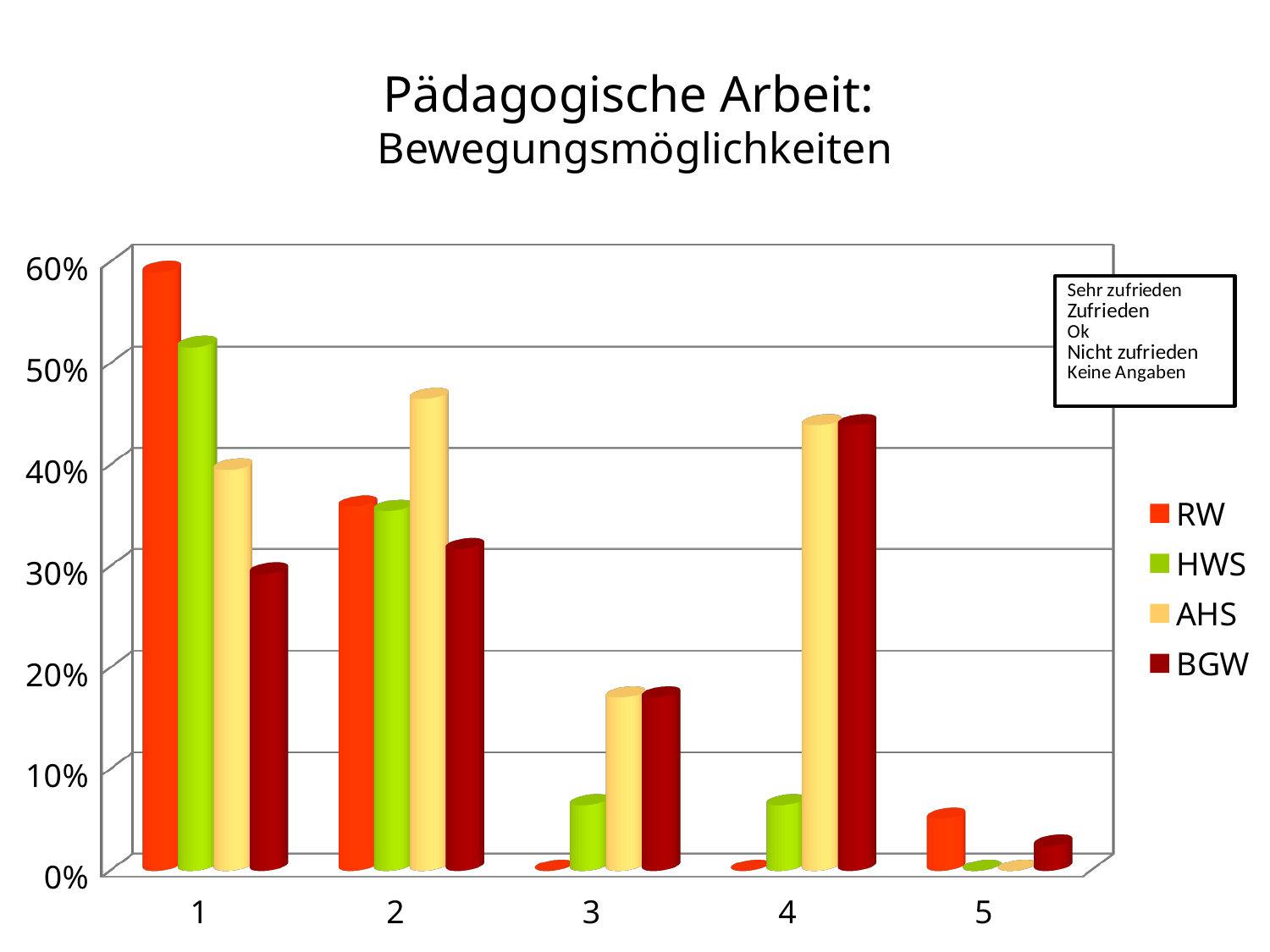
What kind of chart is shown on the slide? bar chart What is the title of the chart? Pädagogische Arbeit: Bewegungsmöglichkeiten Is the value for HWS in category 3 greater or less than 10%? less Is the value for AHS in category 2 greater or less than 40%? greater Which is larger in category 4, the value for AHS or the value for HWS? AHS Which series has the highest value in category 1? RW How many categories are shown on the x axis? 5 How many series does the legend list? 4 Is the value for RW in category 1 greater or less than 50%? greater Does the value for RW rise or fall from category 1 to category 2? fall Which series has the highest value in category 2? AHS Which series has the lowest value in category 1? BGW